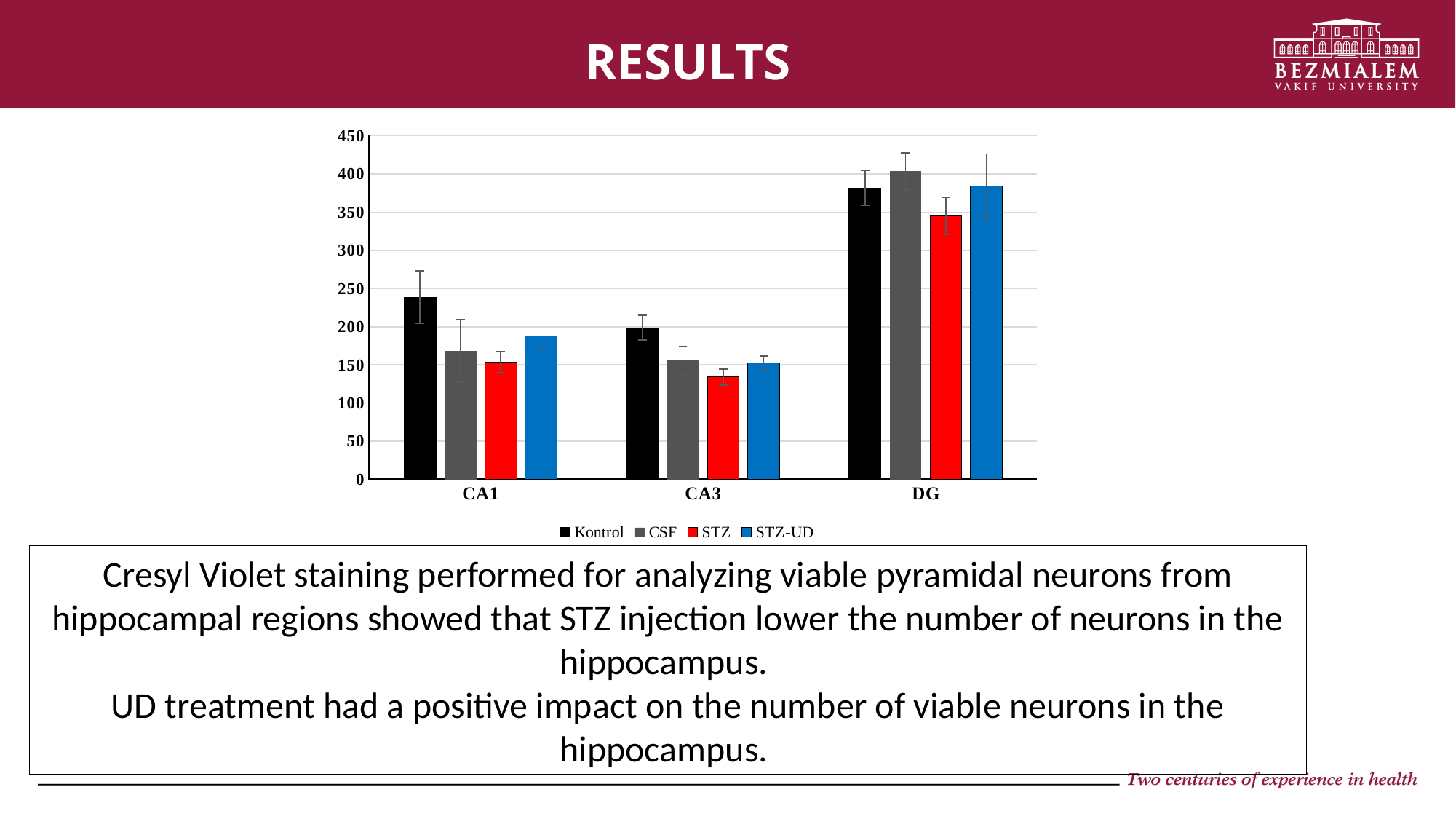
How many series does the chart's legend list? 4 Is the Kontrol value for CA1 greater or less than 200? greater Is the STZ value for CA3 greater or less than 150? less Which series is shown in red in the chart? STZ Which category has the highest Kontrol value? DG What kind of chart is shown on the slide? bar chart Which is larger: the STZ value for DG or the STZ value for CA1? DG Is the STZ value for CA1 greater or less than 200? less In the CA1 category, which is larger: the Kontrol value or the STZ-UD value? Kontrol Within the CA3 category, which series has the lowest value? STZ How many categories are shown on the x axis of the chart? 3